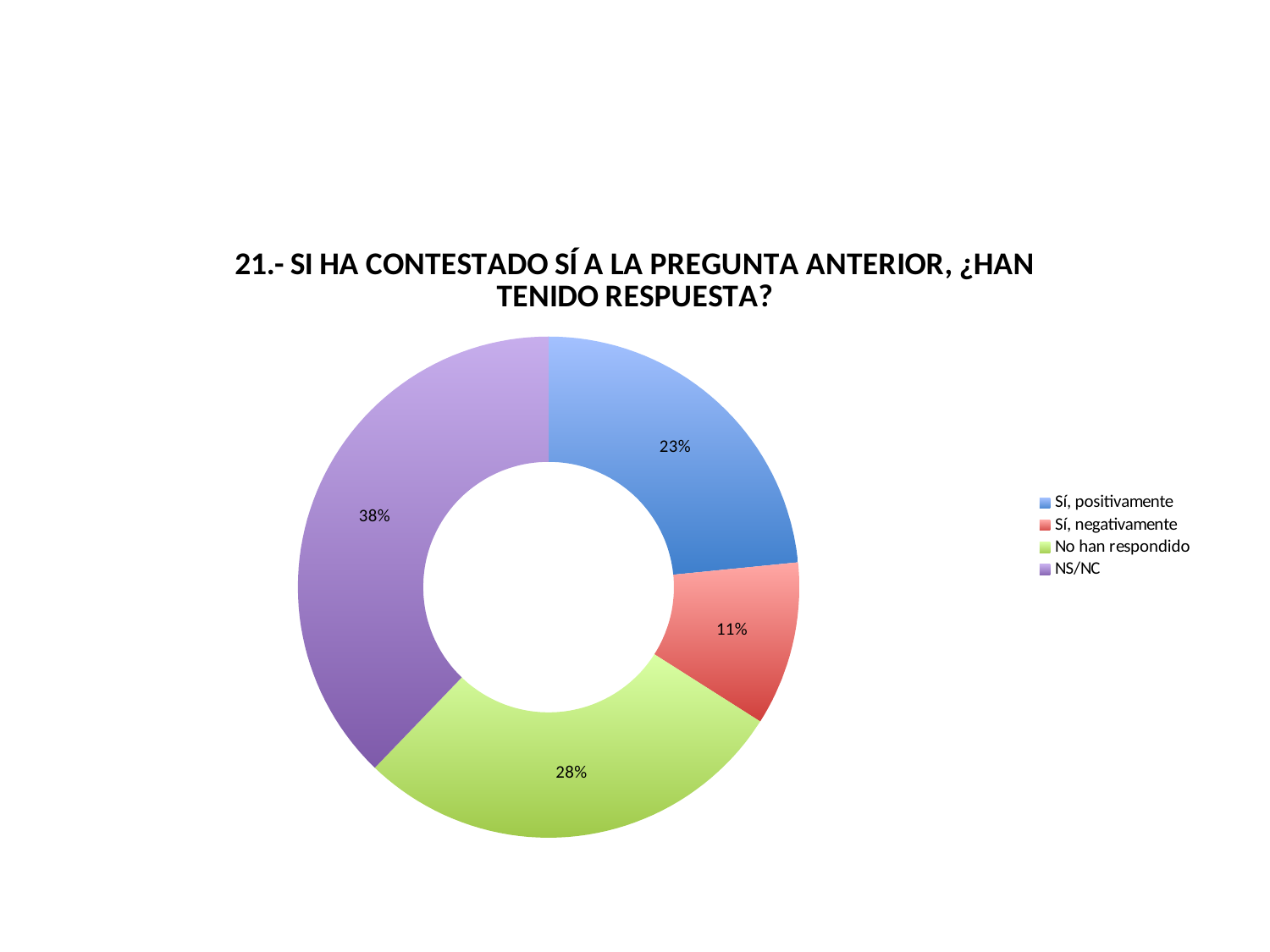
Which category has the largest share? NS/NC What kind of chart is shown on the slide? Doughnut (pie) chart What is the value shown for 'Sí, negativamente'? 11% What is the value for 'NS/NC'? 38% Which is larger, 'No han respondido' or 'Sí, positivamente'? No han respondido What percentage is shown for 'No han respondido'? 28% What share of the chart does 'Sí, positivamente' represent? 23% What is the difference between 'No han respondido' and 'Sí, negativamente'? 17% What colour represents 'NS/NC' in the chart? Purple Which category has the smallest share? Sí, negativamente How many categories does the chart show? 4 What is the difference between the shares of 'NS/NC' and 'Sí, positivamente'? 15%